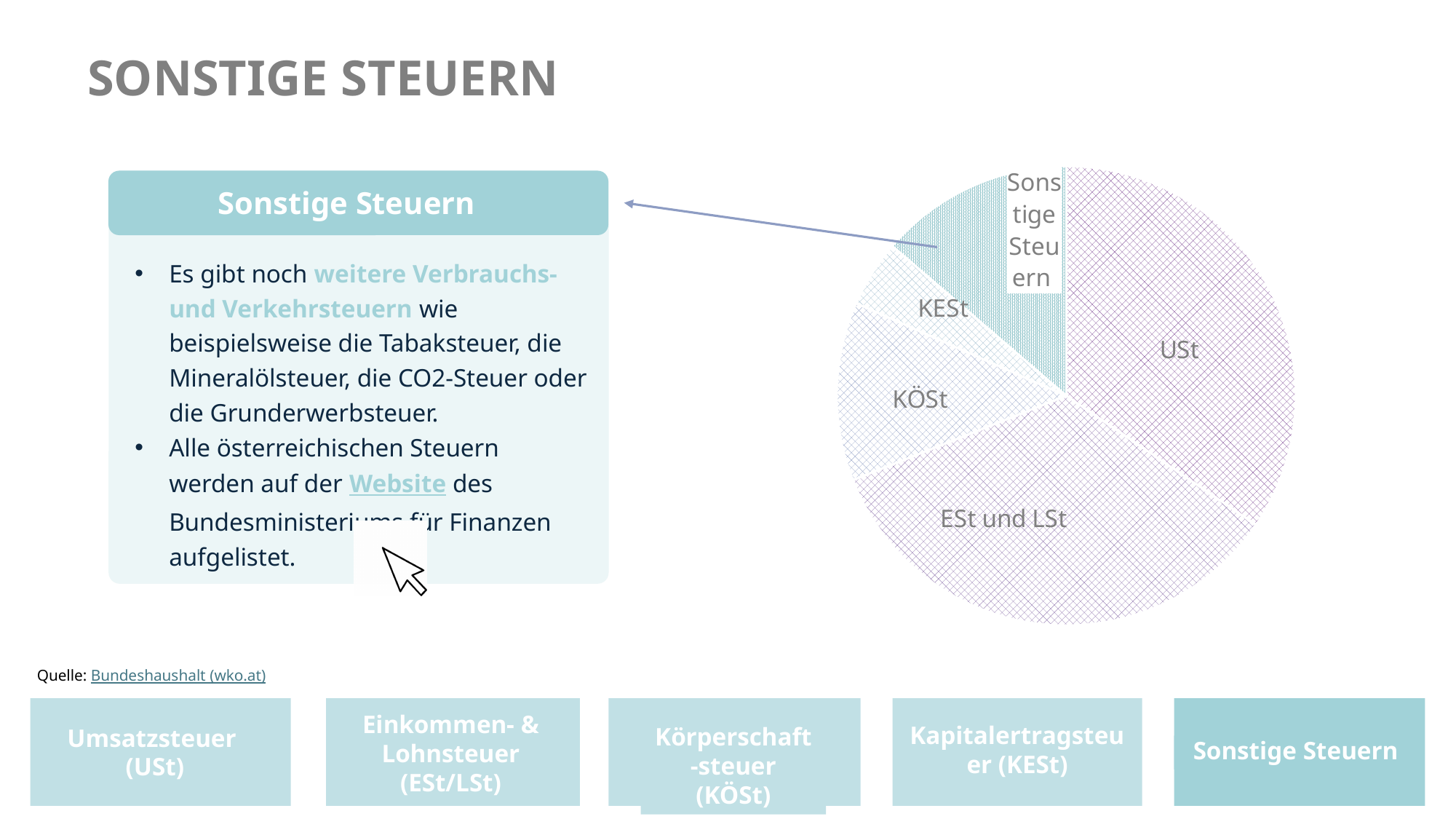
Which slice of the pie chart is the smallest? KESt Which slice is larger in the pie chart, ESt und LSt or KESt? ESt und LSt How many slices does the pie chart have? 5 Which slice is larger in the pie chart, KÖSt or KESt? KÖSt Which slice is larger in the pie chart, USt or KÖSt? USt What is the title of the slide containing the pie chart? SONSTIGE STEUERN What kind of chart is shown on the slide? pie chart Which slice of the pie chart does the arrow from the text box point to? Sonstige Steuern